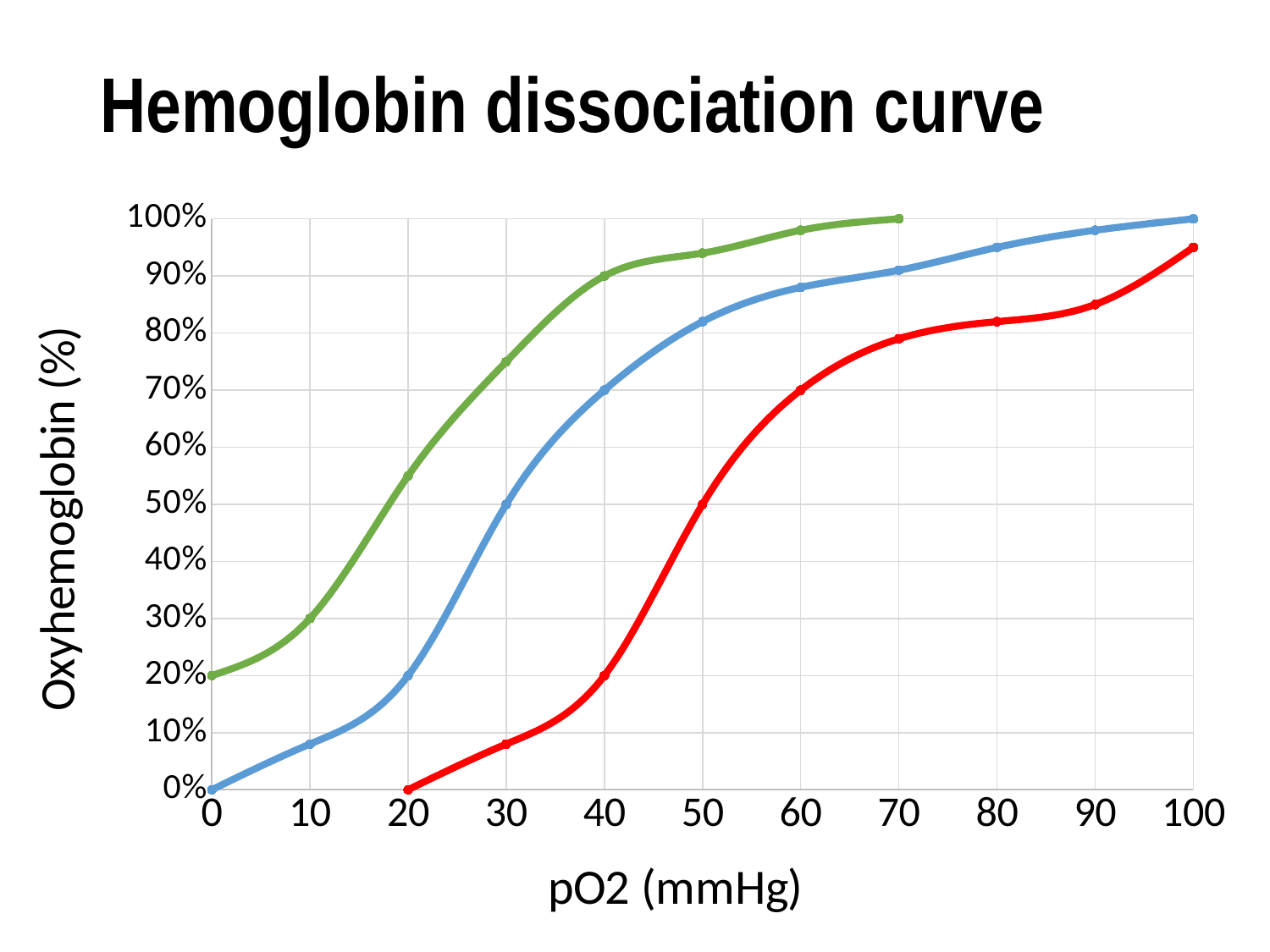
What is the label of the x axis? pO2 (mmHg) What is the oxyhemoglobin value of the green line at a pO2 of 40 mmHg? 90% What is the oxyhemoglobin value of the blue line at a pO2 of 30 mmHg? 50% Do the values of the blue line rise or fall as pO2 increases? rise What is the title of the chart? Hemoglobin dissociation curve Is the value of the red line at a pO2 of 30 mmHg greater or less than 10%? less At a pO2 of 40 mmHg, which line has the higher oxyhemoglobin value, the green line or the red line? green line What is the oxyhemoglobin value of the red line at a pO2 of 50 mmHg? 50% What is the oxyhemoglobin value of the green line at a pO2 of 0 mmHg? 20% Is the value of the blue line at a pO2 of 50 mmHg greater or less than 80%? greater What kind of chart is shown on the slide? line chart How many lines are plotted on the chart? 3